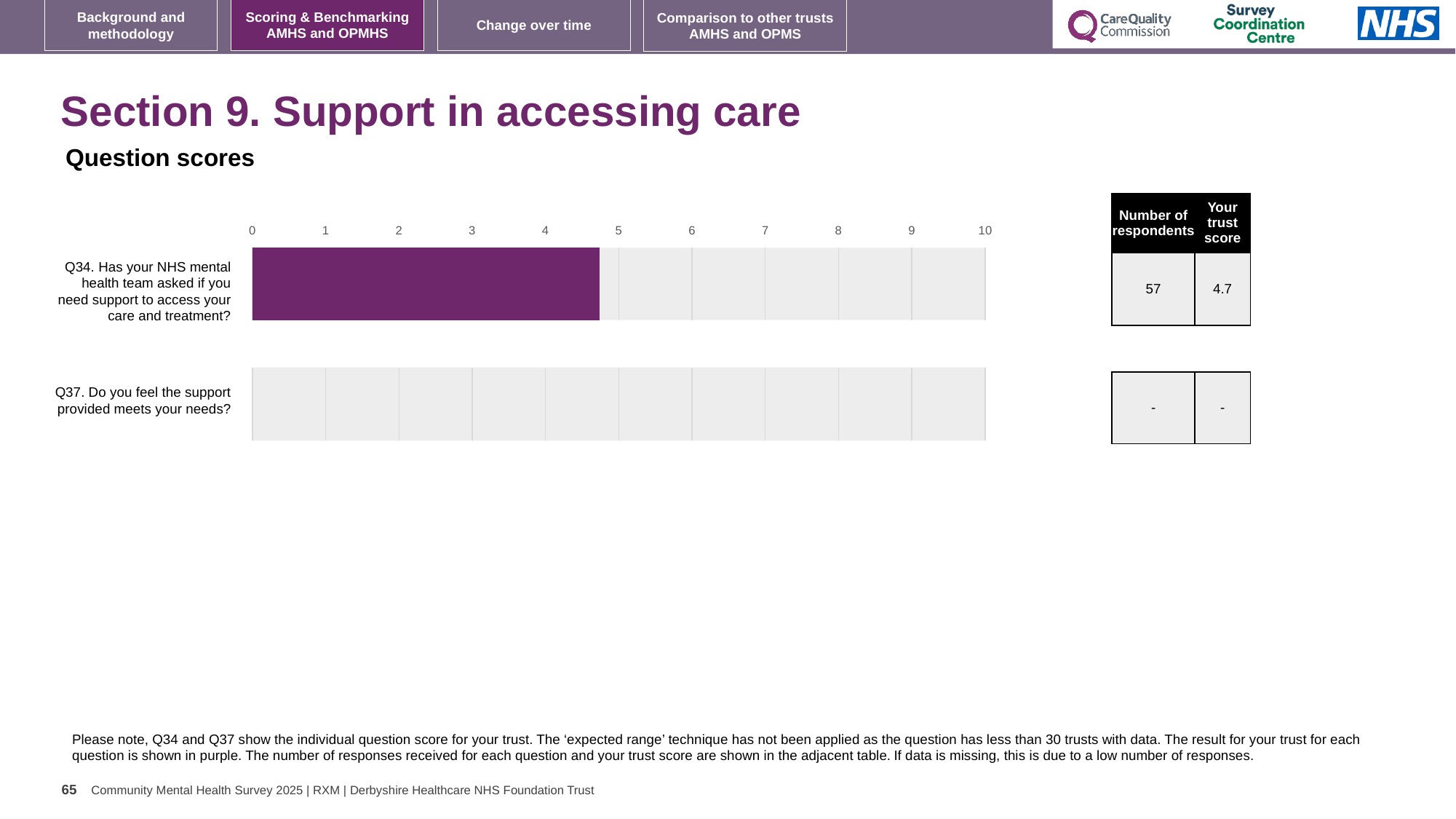
What is the trust score for Q34 shown in the adjacent table? 4.7 How many respondents are shown for Q34 in the adjacent table? 57 Is the value of the bar for Q34 greater or less than 4? greater Which of the two questions has the higher plotted score, Q34 or Q37? Q34 What kind of chart is shown on the slide? bar chart Is the value of the bar for Q34 greater or less than 5? less How many questions (categories) are listed on the chart? 2 What is the trust score shown for Q37 in the adjacent table? - Which question has a purple bar plotted on the chart? Q34 What is the maximum value shown on the chart's horizontal axis? 10